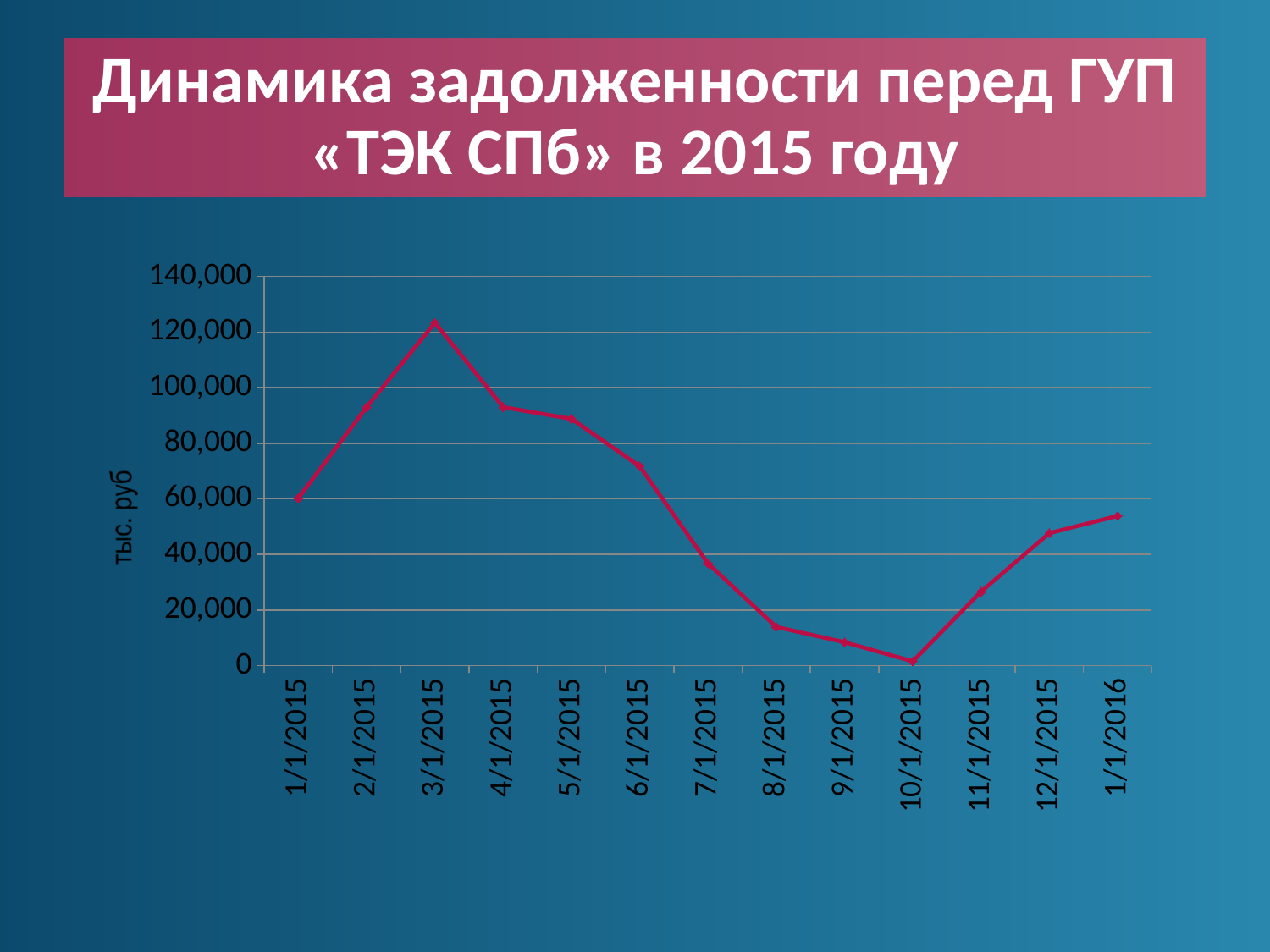
On which date does the debt reach its highest value? 3/1/2015 On which date does the debt reach its lowest value? 10/1/2015 What is the title of the chart? Динамика задолженности перед ГУП «ТЭК СПб» в 2015 году What kind of chart is shown on the slide? line chart Do the values rise or fall between 3/1/2015 and 10/1/2015? fall Is the value for 6/1/2015 greater or less than 60,000? greater How many data points are plotted on the line? 13 What is the label on the vertical axis? тыс. руб Is the value for 3/1/2015 greater or less than 120,000? greater Which date has the larger value, 4/1/2015 or 7/1/2015? 4/1/2015 Is the value for 8/1/2015 greater or less than 20,000? less